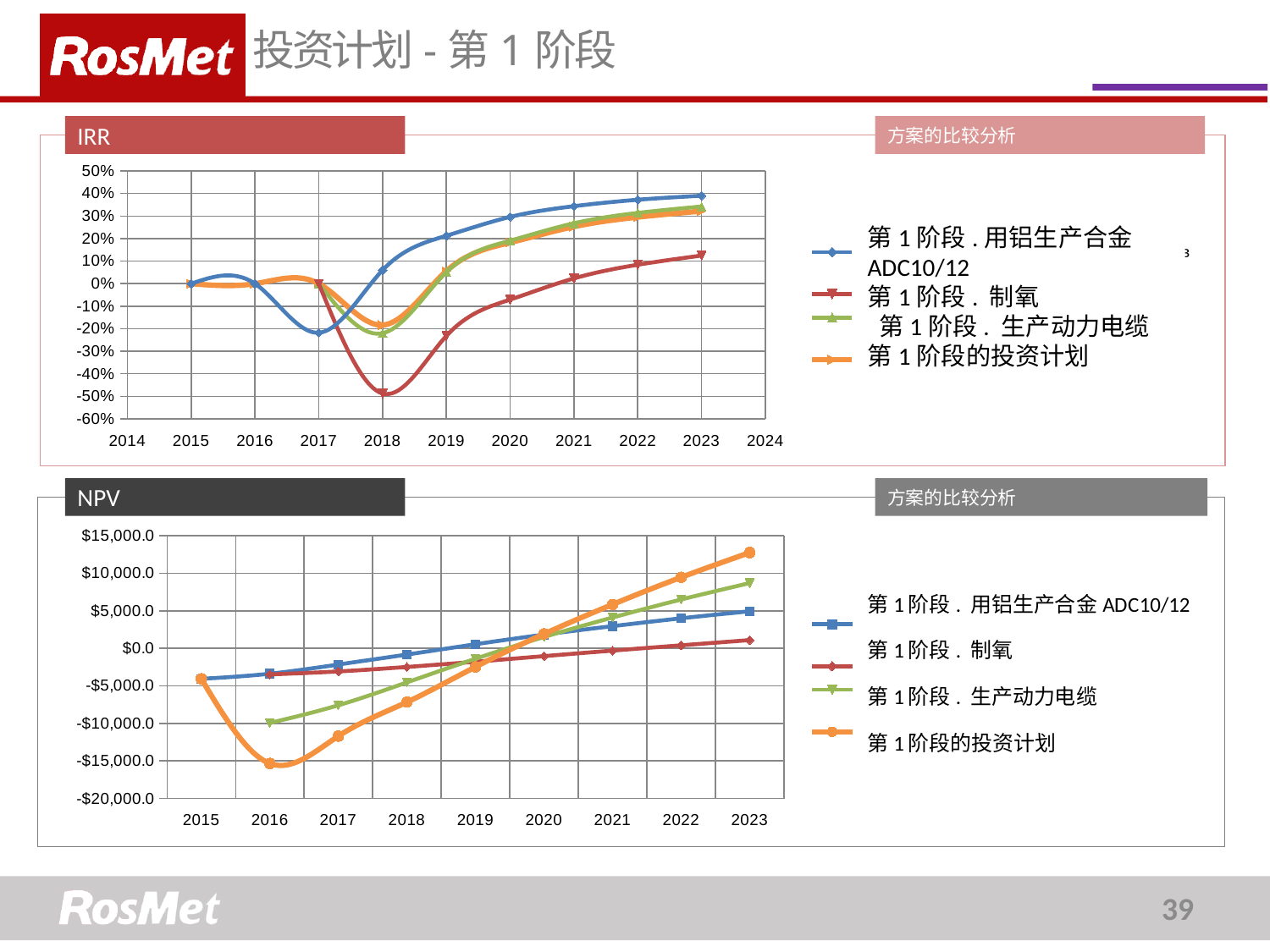
In the NPV chart, does the value for 第 1 阶段 . 用铝生产合金 ADC10/12 rise or fall from 2015 to 2023? rise In the IRR chart, is the 2018 value for 第 1 阶段 . 制氧 greater or less than -40%? less In the IRR chart, which series has the lowest value in 2018? 第 1 阶段 . 制氧 In the NPV chart, is the 2023 value for 第 1 阶段的投资计划 greater or less than $10,000.0? greater In the NPV chart, which series has the lowest value in 2016? 第 1 阶段的投资计划 In the IRR chart, which series has the highest value in 2023? 第 1 阶段 . 用铝生产合金 ADC10/12 In the NPV chart, which is larger in 2023: the value for 第 1 阶段 . 生产动力电缆 or the value for 第 1 阶段 . 制氧? 第 1 阶段 . 生产动力电缆 In the NPV chart, which series has the highest value in 2023? 第 1 阶段的投资计划 How many series does the legend of the NPV chart list? 4 How many years are plotted on the x axis of the NPV chart? 9 What kind of chart is the IRR chart at the top of the slide? line chart In the IRR chart, is the 2023 value for 第 1 阶段 . 用铝生产合金 ADC10/12 greater or less than 30%? greater